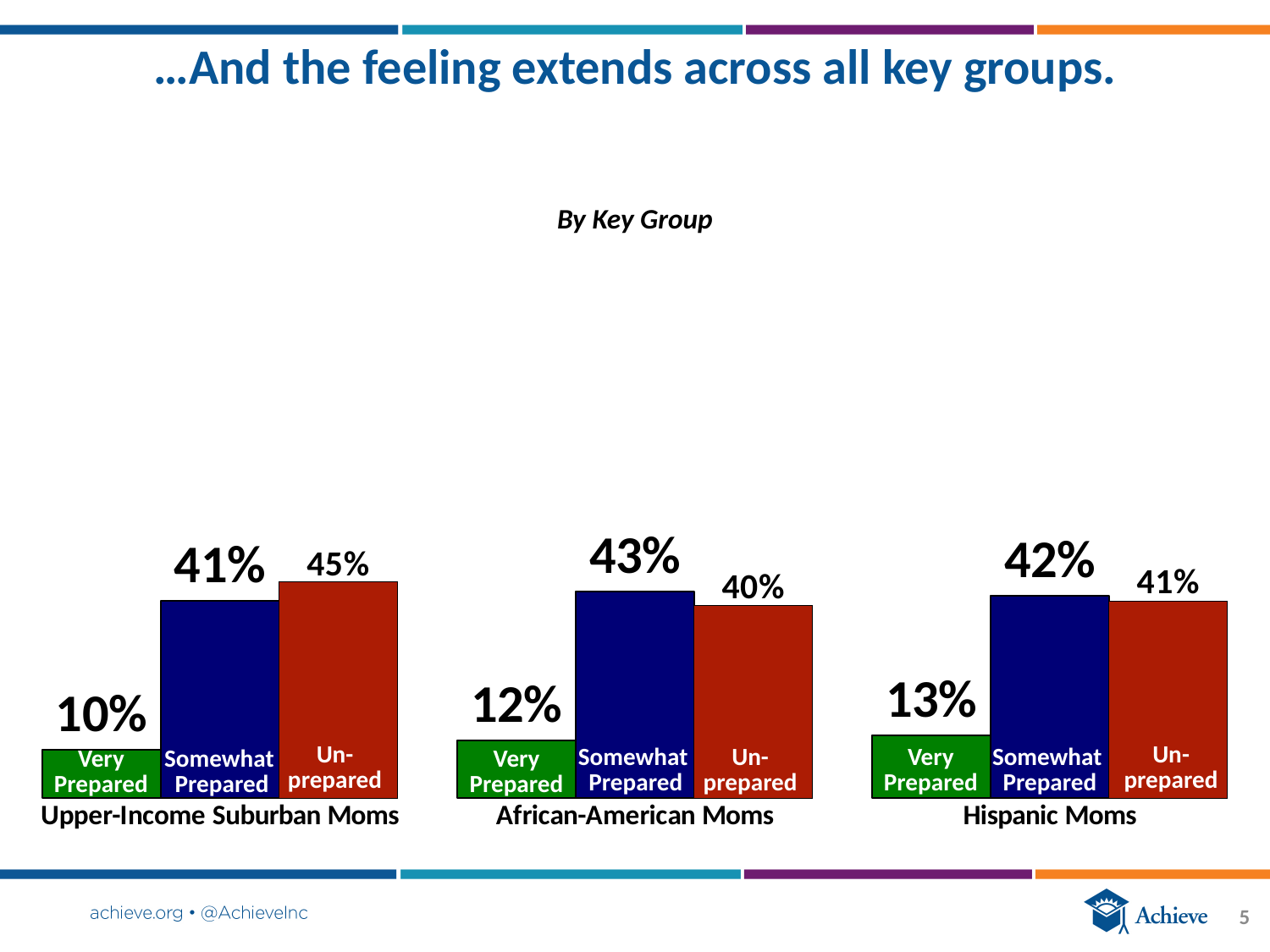
What kind of chart is used for the Hispanic Moms group? Bar chart In the Hispanic Moms chart, which category has the highest value? Somewhat Prepared In the Upper-Income Suburban Moms chart, what percentage are Very Prepared? 10% In the African-American Moms chart, what percentage are Somewhat Prepared? 43% What colour is the Very Prepared bar in each chart? Green How many categories are shown in the African-American Moms chart? 3 In the Upper-Income Suburban Moms chart, what is the difference between the Unprepared and Very Prepared values? 35% In the Hispanic Moms chart, which is larger: Very Prepared or Somewhat Prepared? Somewhat Prepared In the African-American Moms chart, what is the difference between the Somewhat Prepared and Unprepared values? 3% In the African-American Moms chart, which category has the lowest value? Very Prepared In the Upper-Income Suburban Moms chart, which category has the highest value? Unprepared In the Hispanic Moms chart, what percentage are Unprepared? 41%